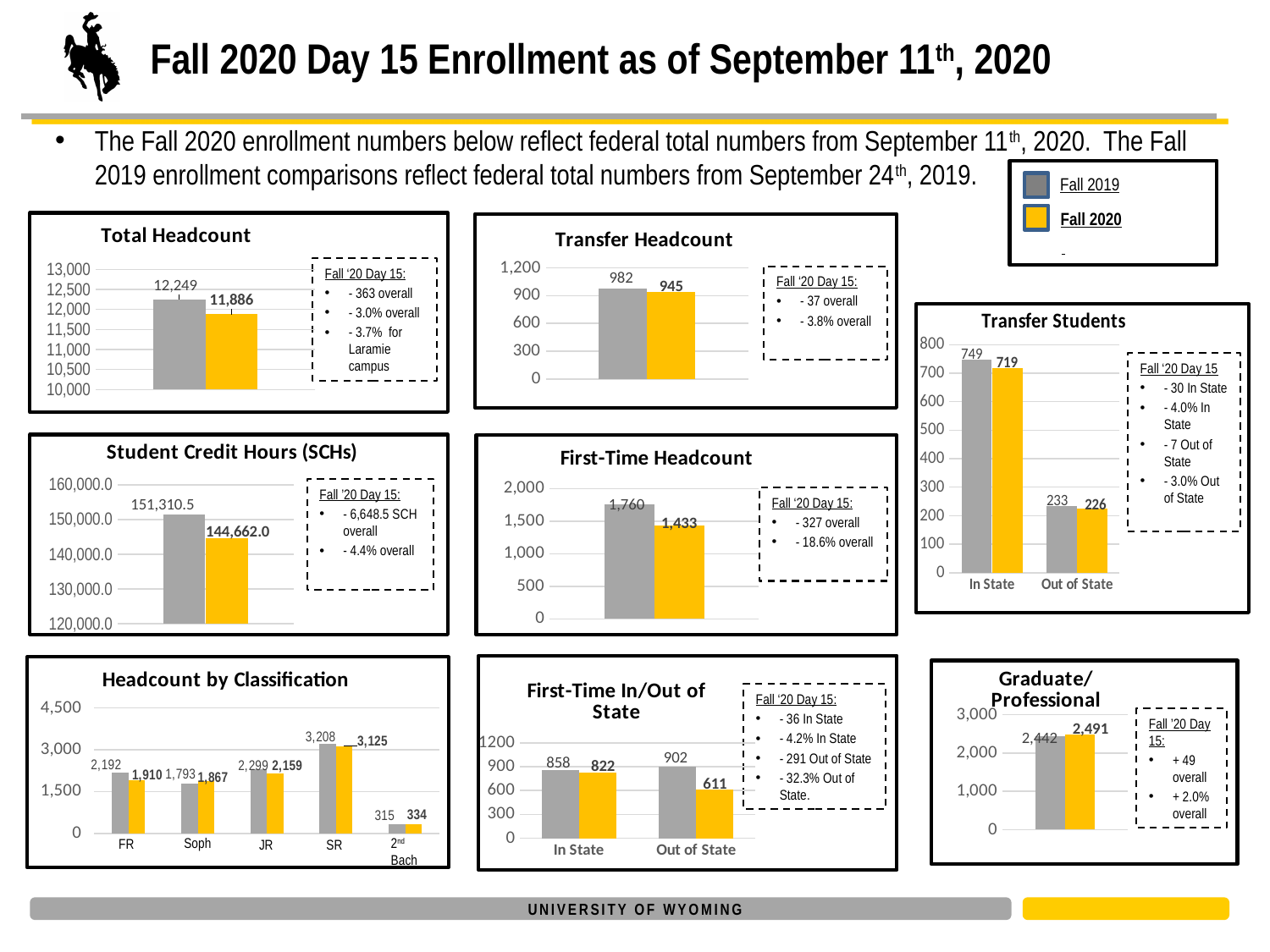
In the Transfer Students chart, what is the difference between the Fall 2019 and Fall 2020 In State values? 30 In the Transfer Headcount chart, what is the Fall 2019 value? 982 In the First-Time Headcount chart, which is larger, the Fall 2019 or the Fall 2020 value? Fall 2019 In the Total Headcount chart, what is the difference between the Fall 2019 and Fall 2020 values? 363 In the Student Credit Hours (SCHs) chart, what is the Fall 2020 value? 144,662.0 In the Headcount by Classification chart, how many classification categories are shown on the x axis? 5 In the Headcount by Classification chart, what is the Fall 2020 value for Soph? 1,867 In the First-Time In/Out of State chart, what is the Fall 2020 value for Out of State? 611 In the Graduate/Professional chart, which is larger, the Fall 2019 or the Fall 2020 value? Fall 2020 What type of chart is the Total Headcount chart? Bar chart In the Total Headcount chart, what is the Fall 2020 value? 11,886 In the Headcount by Classification chart, which classification has the highest Fall 2019 headcount? SR